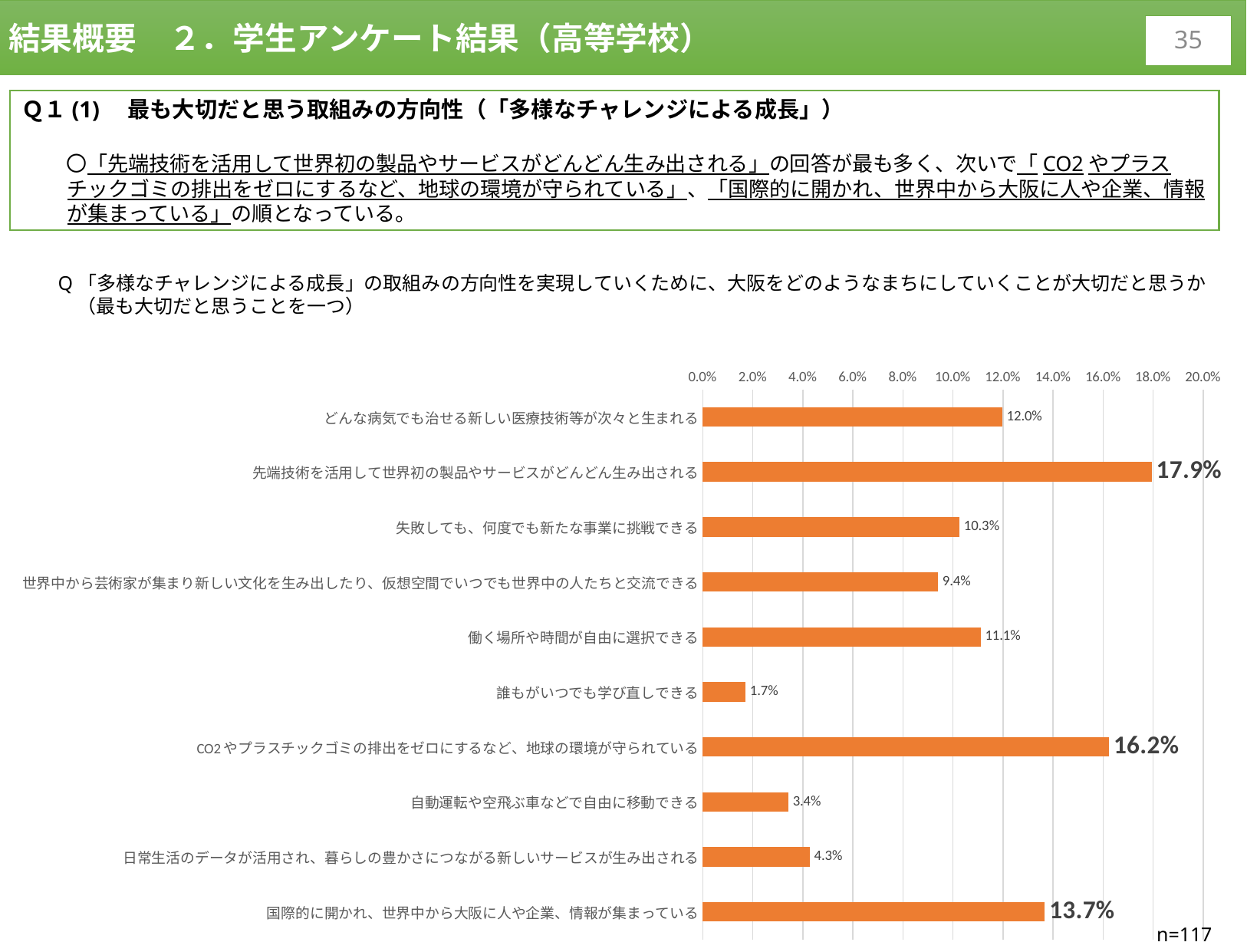
Which category has the lowest value? 誰もがいつでも学び直しできる How many categories are shown in the chart? 10 What kind of chart is shown on the slide? bar chart What is the value for 「働く場所や時間が自由に選択できる」? 11.1% What is the value for 「誰もがいつでも学び直しできる」? 1.7% What is the value for 「先端技術を活用して世界初の製品やサービスがどんどん生み出される」? 17.9% What is the difference between the values for 「先端技術を活用して世界初の製品やサービスがどんどん生み出される」 and 「CO2やプラスチックゴミの排出をゼロにするなど、地球の環境が守られている」? 1.7% Which is larger: the value for 「どんな病気でも治せる新しい医療技術等が次々と生まれる」 or 「失敗しても、何度でも新たな事業に挑戦できる」? どんな病気でも治せる新しい医療技術等が次々と生まれる What is the value for 「自動運転や空飛ぶ車などで自由に移動できる」? 3.4% What is the sample size (n) shown on the chart? n=117 Is the value for 「国際的に開かれ、世界中から大阪に人や企業、情報が集まっている」 greater or less than 12.0%? greater Which category has the highest value? 先端技術を活用して世界初の製品やサービスがどんどん生み出される